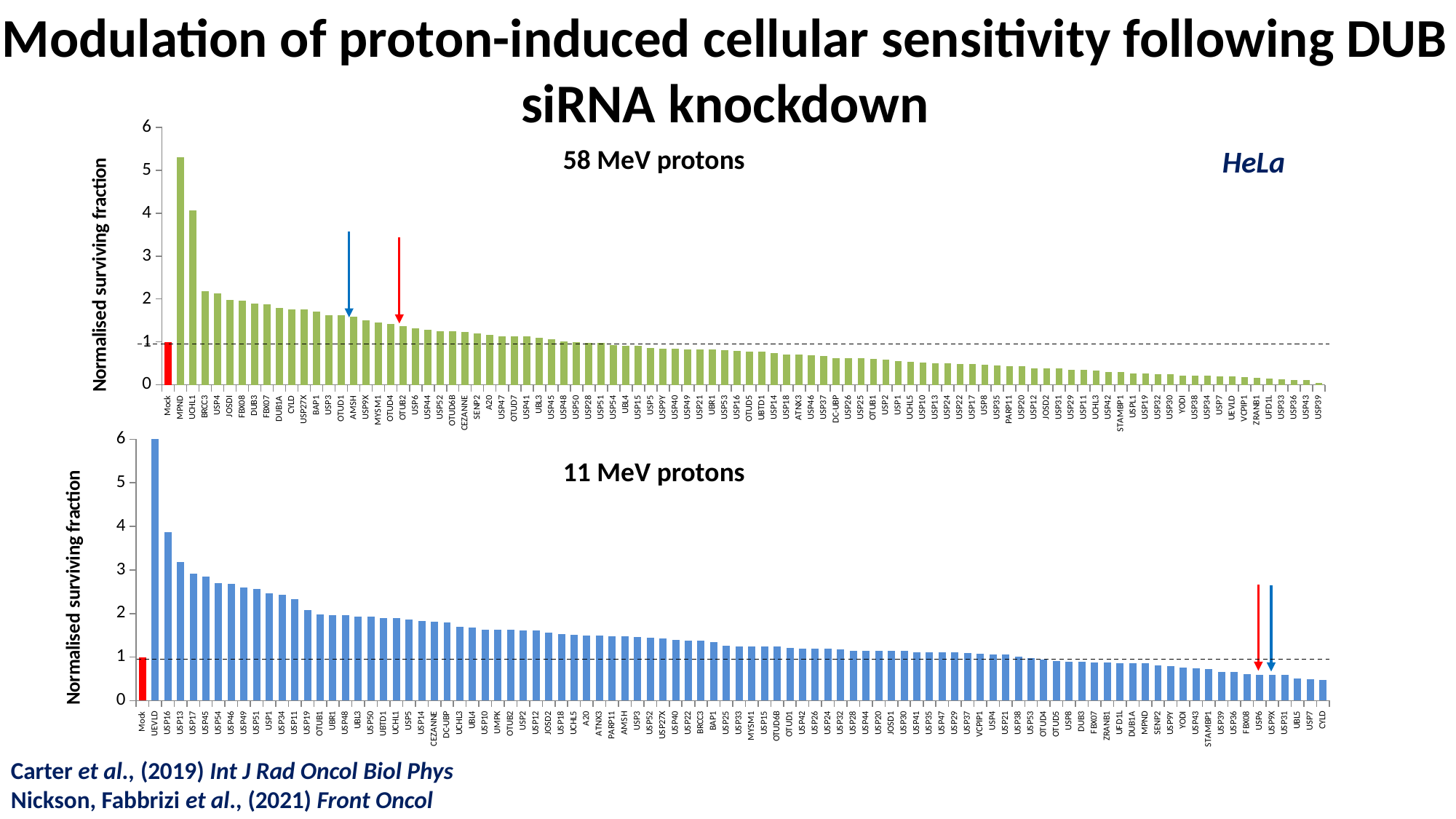
Which cell line is named on the slide next to the '58 MeV protons' chart? HeLa In the '11 MeV protons' chart, which category has the lowest normalised surviving fraction? CYLD In the '58 MeV protons' chart, which category has the lowest normalised surviving fraction? USP39 In the '11 MeV protons' chart, which is larger, the value for UEVLD or the value for USP13? UEVLD In the '58 MeV protons' chart, do the bar values rise or fall from left to right along the x axis? fall In the '11 MeV protons' chart, is the value for USP16 greater or less than 3? greater In the '58 MeV protons' chart, is the value for MPND greater or less than 5? greater What kind of chart is the '58 MeV protons' chart? bar chart In the '11 MeV protons' chart, which category has the highest normalised surviving fraction? UEVLD In the '58 MeV protons' chart, which category has the highest normalised surviving fraction? MPND What is the y-axis label of the '11 MeV protons' chart? Normalised surviving fraction